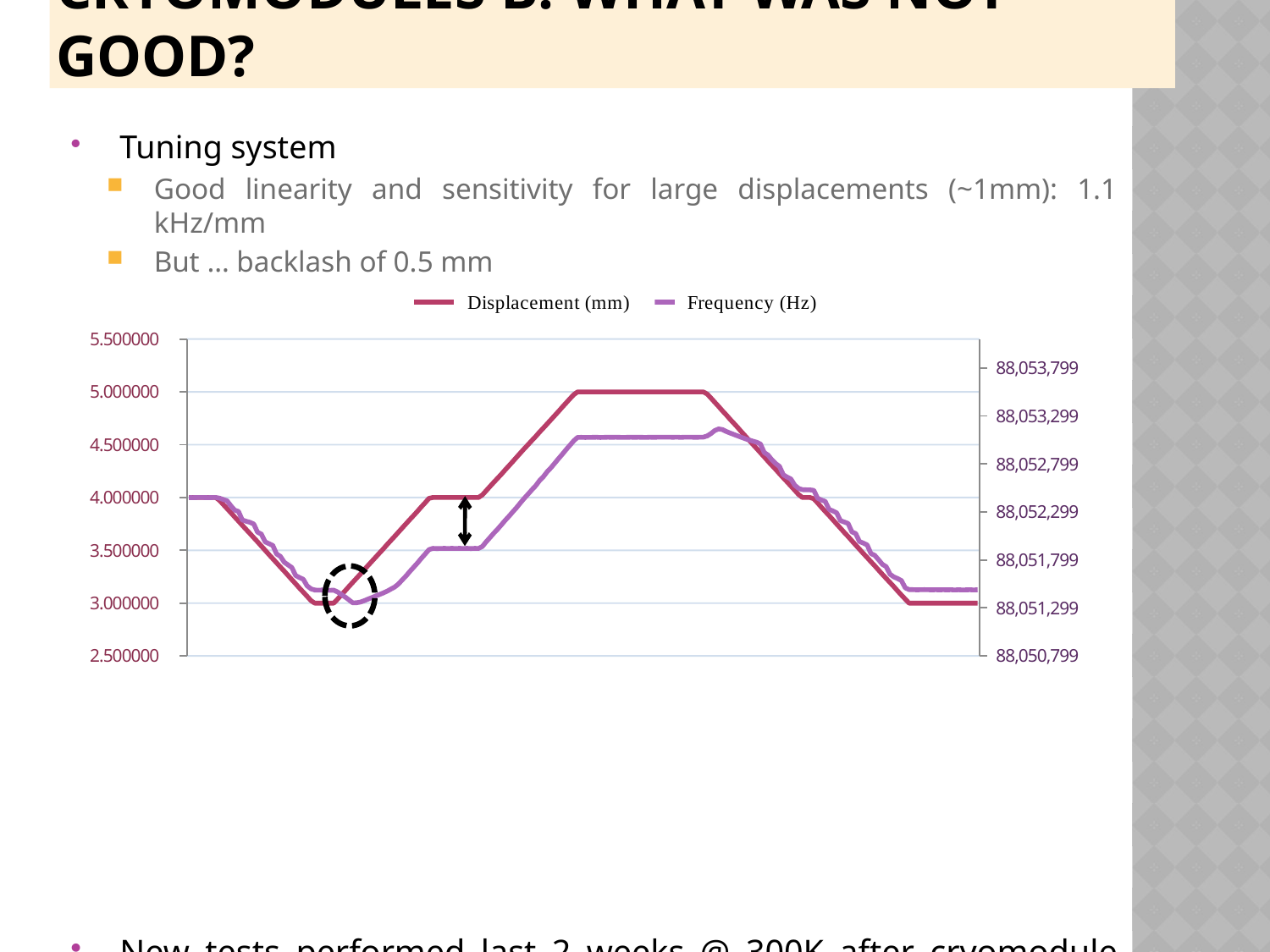
At what value does the Displacement (mm) series end at the right edge of the chart? 3.000000 What are the two series named in the chart legend? Displacement (mm) and Frequency (Hz) At what value does the Displacement (mm) series start at the left edge of the chart? 4.000000 What kind of chart is shown on the slide? line chart How many series does the chart legend list? 2 Is the lowest value of the Frequency (Hz) series greater or less than 88,051,799? less Does the Displacement (mm) series rise or fall over the final portion of the chart, after its plateau at 5.000000? fall What is the lowest value reached by the Displacement (mm) series? 3.000000 What is the difference between the highest and lowest values of the Displacement (mm) series? 2.000000 What is the lowest tick label on the right-hand (Frequency) axis? 88,050,799 Is the peak value of the Frequency (Hz) series greater or less than 88,053,299? less What is the highest value reached by the Displacement (mm) series? 5.000000